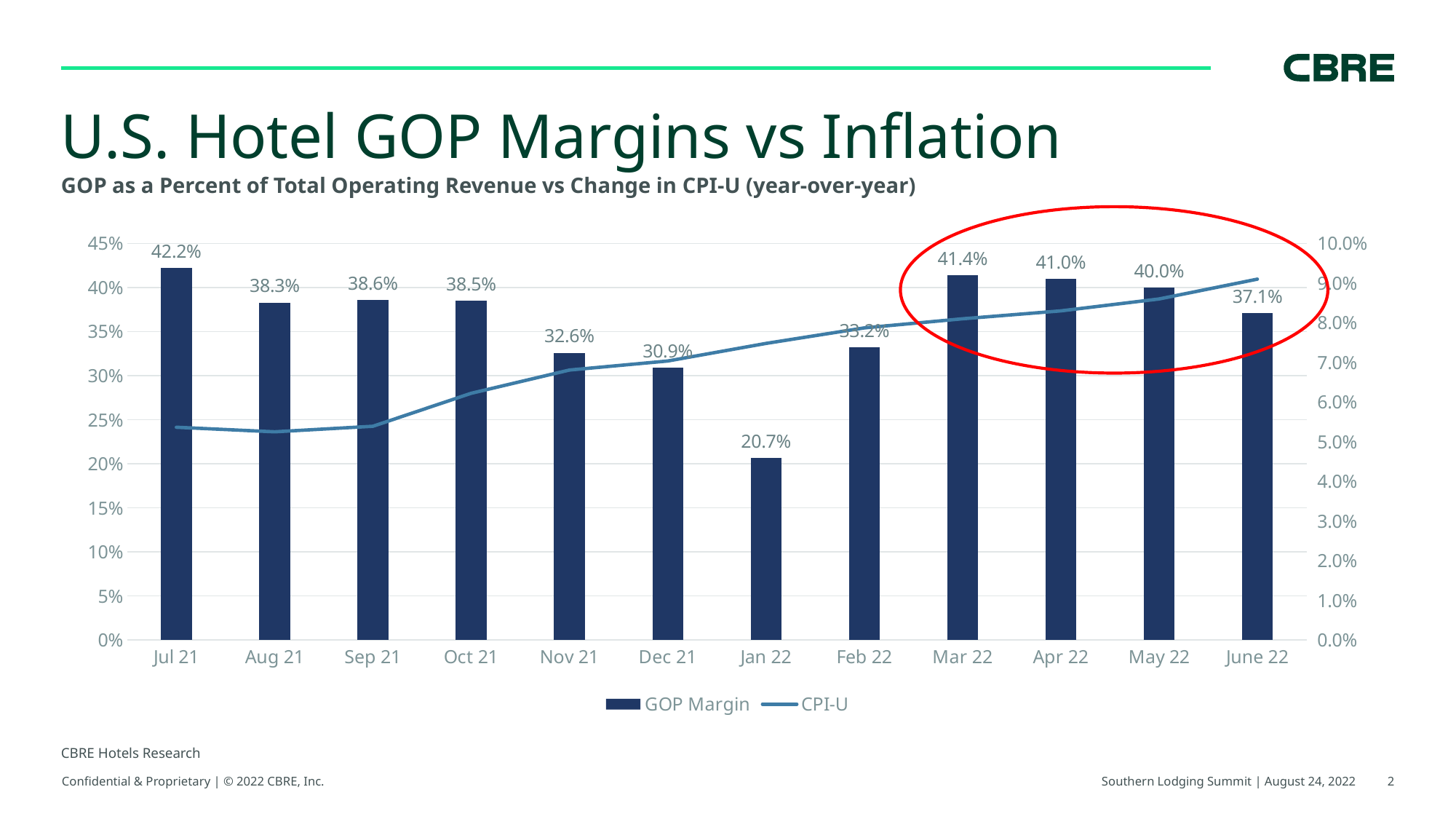
How many series does the legend list? 2 Is the CPI-U value for Jul 21 greater or less than 6.0%? less What is the GOP Margin for Jul 21? 42.2% Which month has the highest GOP Margin? Jul 21 Which month has the lowest GOP Margin? Jan 22 Which is larger, the GOP Margin for Sep 21 or the GOP Margin for Nov 21? Sep 21 What is the difference between the GOP Margin for Mar 22 and the GOP Margin for June 22? 4.3% Is the CPI-U value for June 22 greater or less than 8.0%? greater How many months are shown on the x axis? 12 Does the CPI-U line generally rise or fall from Jul 21 to June 22? rise What is the GOP Margin for June 22? 37.1% What is the GOP Margin for Jan 22? 20.7%